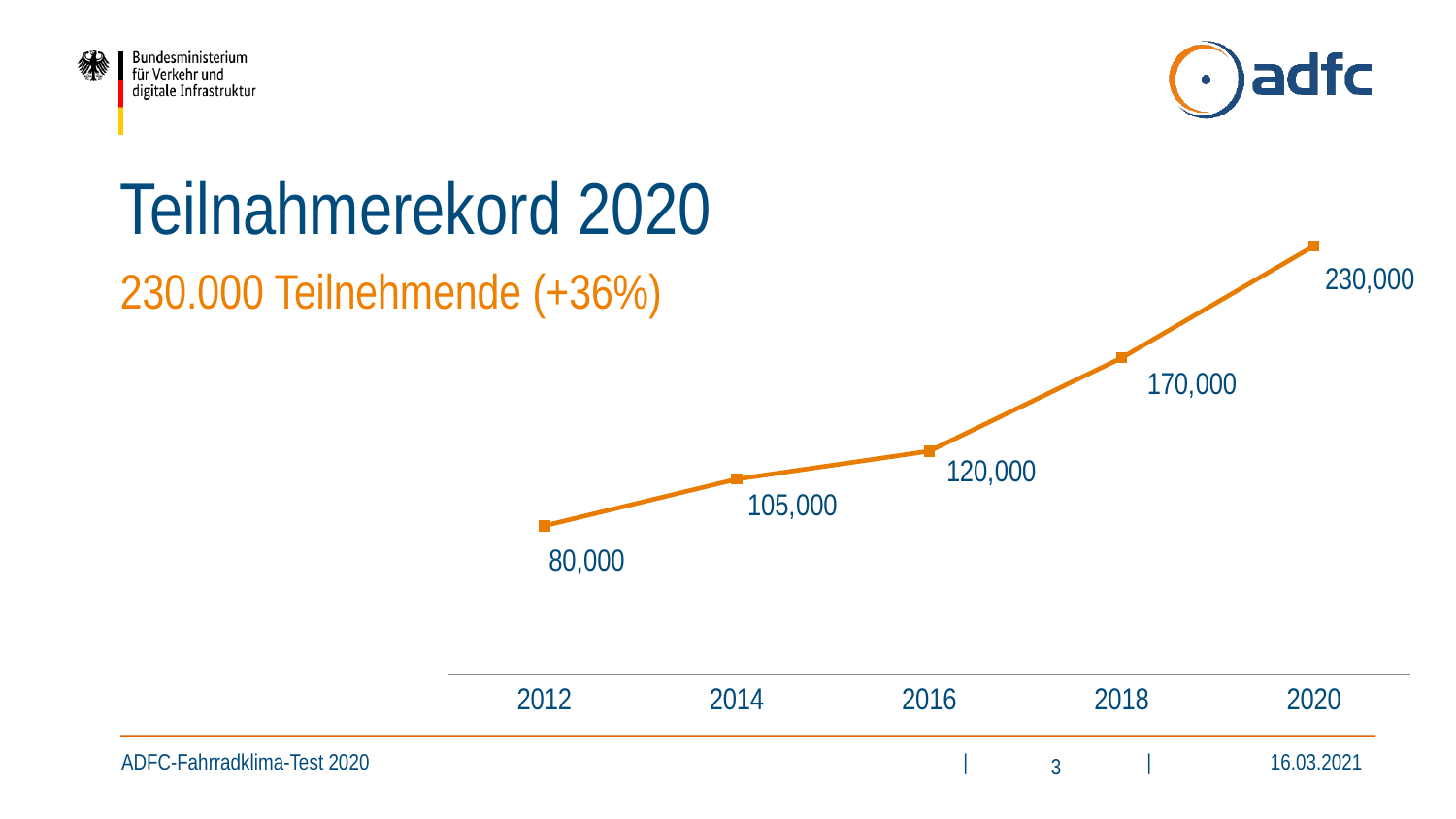
Which is larger, the value for 2016 or the value for 2018? 2018 What is the difference between the values for 2020 and 2018? 60,000 What is the difference between the values for 2014 and 2012? 25,000 Which year has the lowest value? 2012 What is the value for 2020? 230,000 What colour is the line in the chart? orange What is the value for 2012? 80,000 Which year has the highest value? 2020 What is the value for 2016? 120,000 How many data points are plotted on the chart? 5 What kind of chart is shown on the slide? line chart Do the values rise or fall from 2012 to 2020? rise